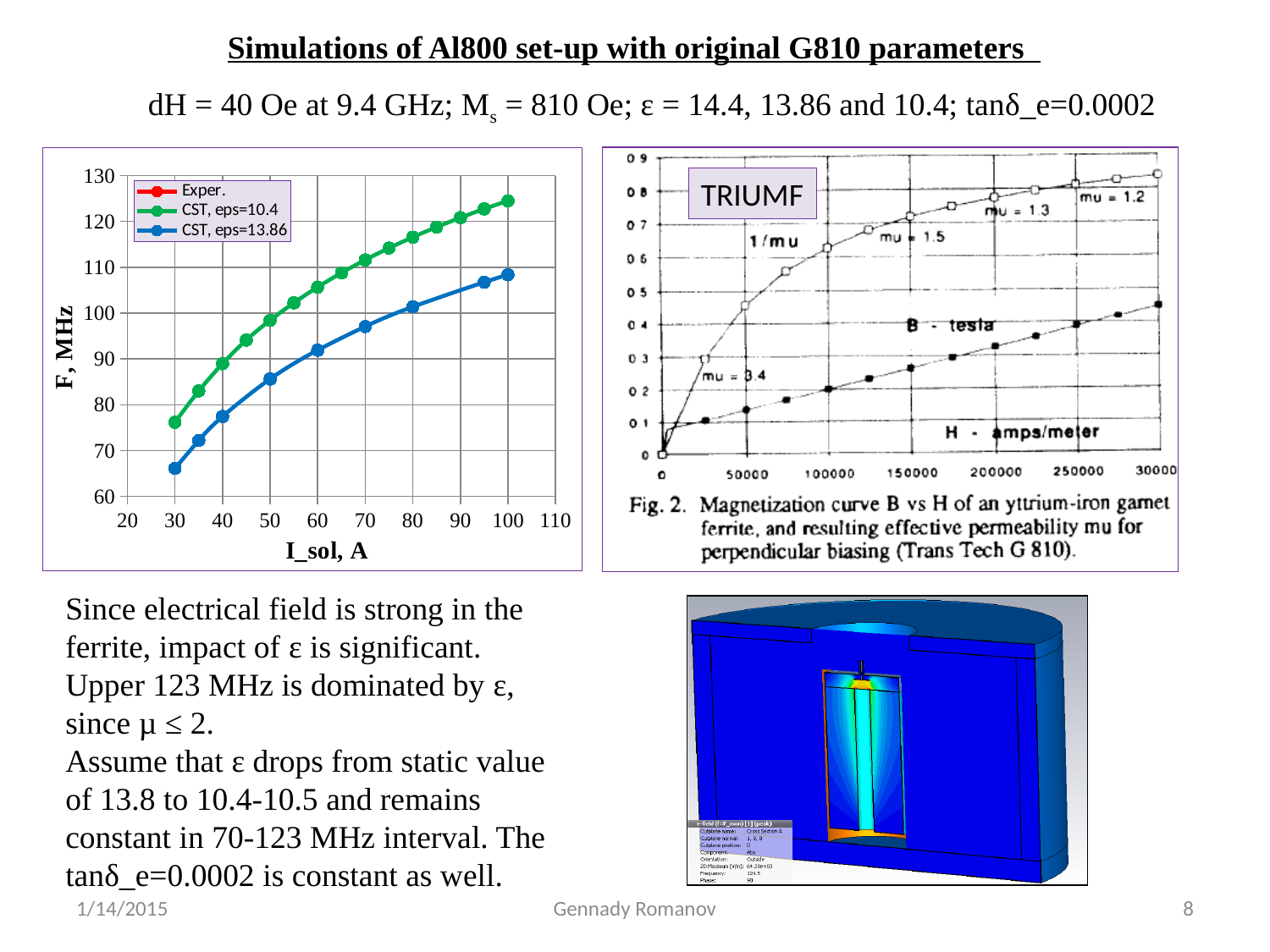
In the left chart, is the value of CST, eps=10.4 at I_sol = 100 A greater or less than 120 MHz? greater What kind of chart is the left chart (F, MHz vs I_sol, A)? line chart In the left chart, which series has the higher value at I_sol = 60 A: CST, eps=10.4 or CST, eps=13.86? CST, eps=10.4 In the left chart, is the value of CST, eps=13.86 at I_sol = 70 A greater or less than 100 MHz? less How many series does the legend of the left chart list? 3 In the left chart, is the value of CST, eps=10.4 at I_sol = 30 A greater or less than 80 MHz? less In the left chart, does the frequency F rise or fall as I_sol increases? rises In the left chart, at which I_sol value does the CST, eps=10.4 series reach its highest frequency? 100 A What is the x-axis label of the left chart? I_sol, A In the left chart, how many data points are plotted for the CST, eps=10.4 series? 15